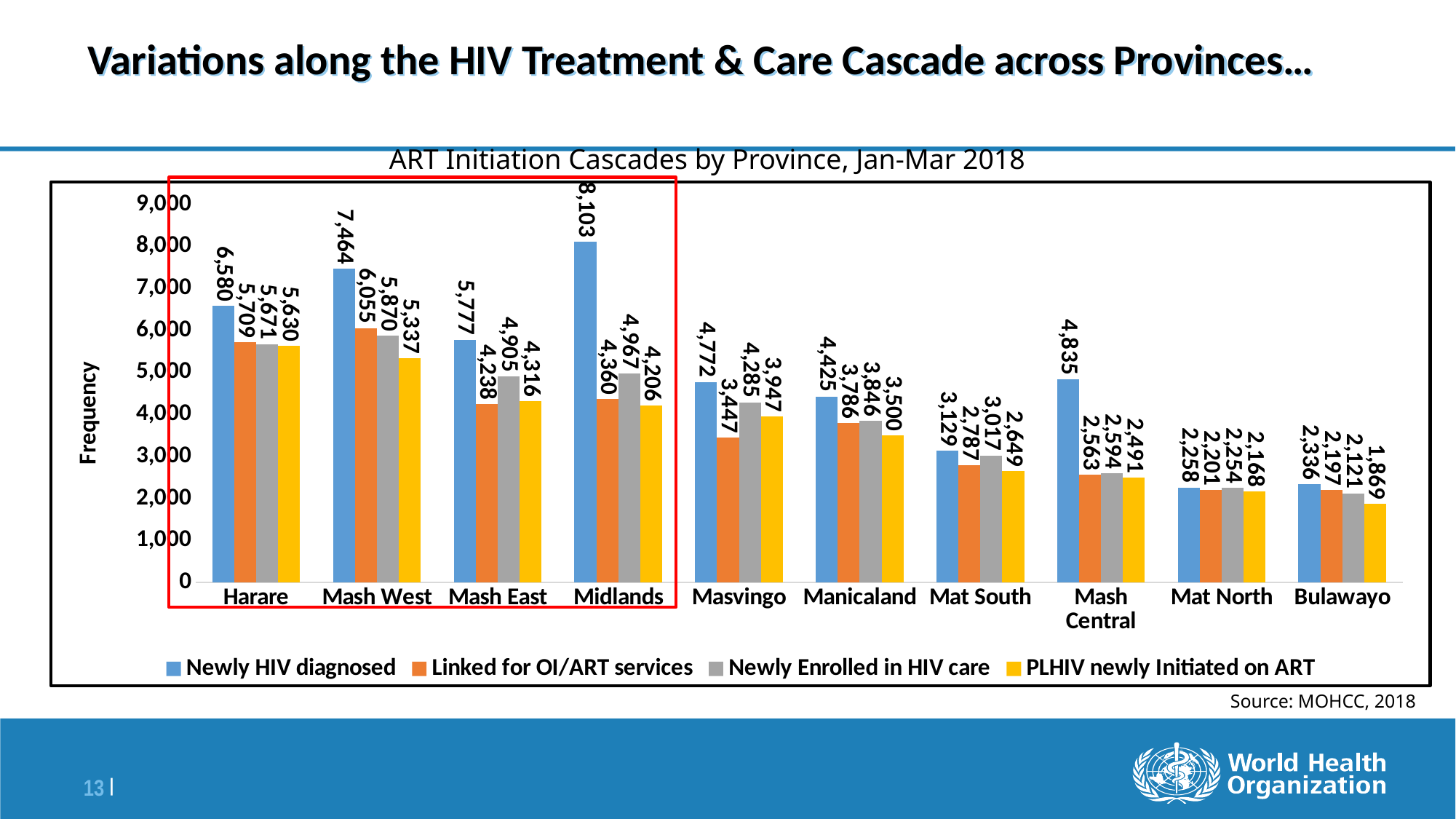
What is the value for Linked for OI/ART services in Masvingo? 3,447 Which is larger in Mash Central: Newly HIV diagnosed or Linked for OI/ART services? Newly HIV diagnosed What is the value for Newly Enrolled in HIV care in Mat South? 3,017 Which province has the lowest value for PLHIV newly Initiated on ART? Bulawayo What is the value for Newly HIV diagnosed in Midlands? 8,103 What is the value for PLHIV newly Initiated on ART in Harare? 5,630 How many series does the legend list? 4 What is the difference between Newly HIV diagnosed and PLHIV newly Initiated on ART in Midlands? 3,897 Which province has the highest value for Newly HIV diagnosed? Midlands What is the title of the chart? ART Initiation Cascades by Province, Jan-Mar 2018 What kind of chart is shown on the slide? Bar chart How many provinces are shown on the x axis? 10